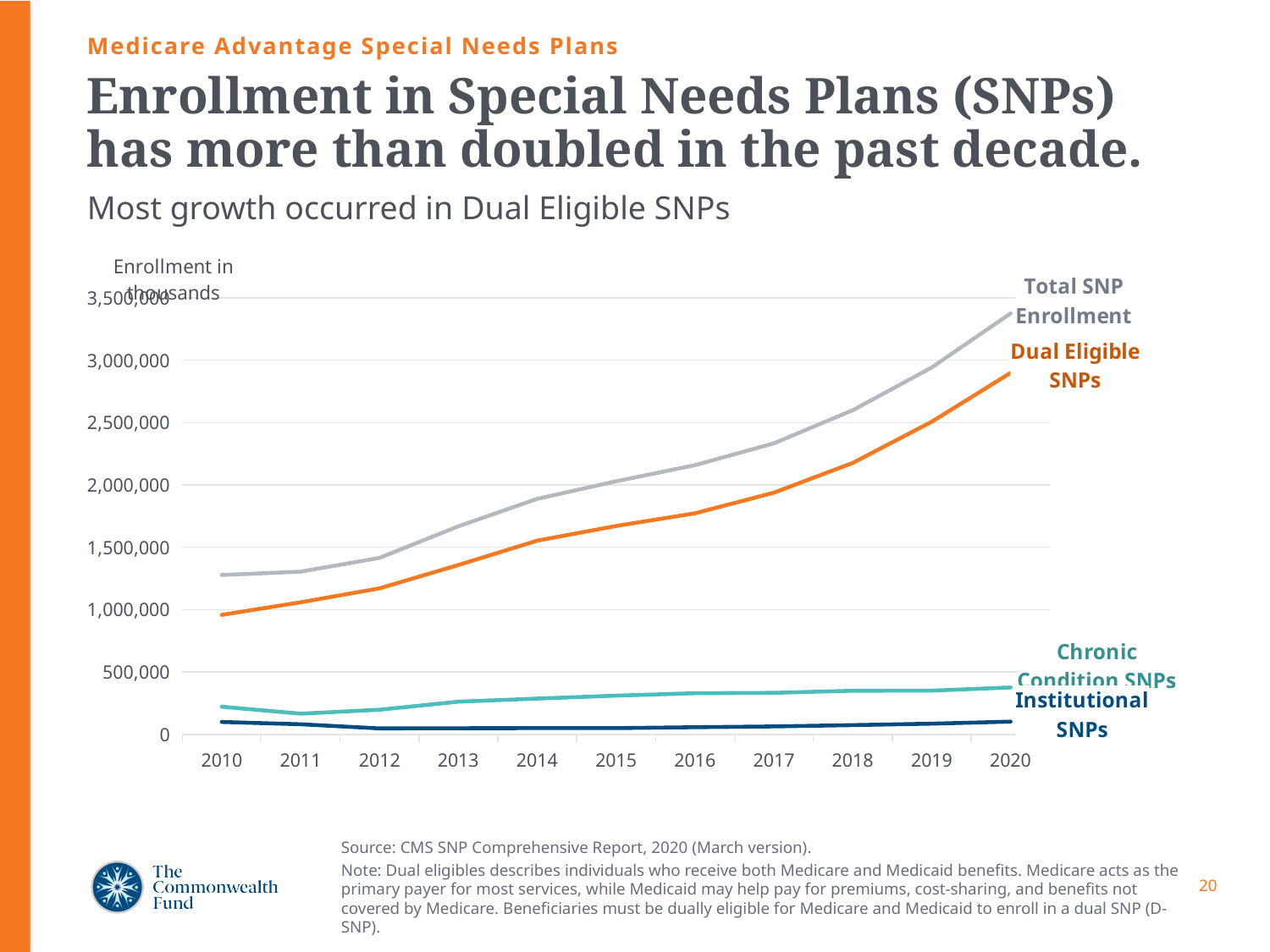
How many series (lines) are labeled on the chart? 4 What is the first year shown on the x axis of the chart? 2010 In 2020, which is larger: Chronic Condition SNPs or Institutional SNPs? Chronic Condition SNPs What kind of chart is shown on the slide? line chart Is the value for Total SNP Enrollment in 2010 greater or less than 1,000,000? greater Which series has the highest value in 2020? Total SNP Enrollment Does Total SNP Enrollment rise or fall from 2010 to 2020? rise Which series has the lowest value in 2020? Institutional SNPs Is the value for Total SNP Enrollment in 2020 greater or less than 3,000,000? greater Is the value for Dual Eligible SNPs in 2010 greater or less than 1,000,000? less How many years are shown along the x axis of the chart? 11